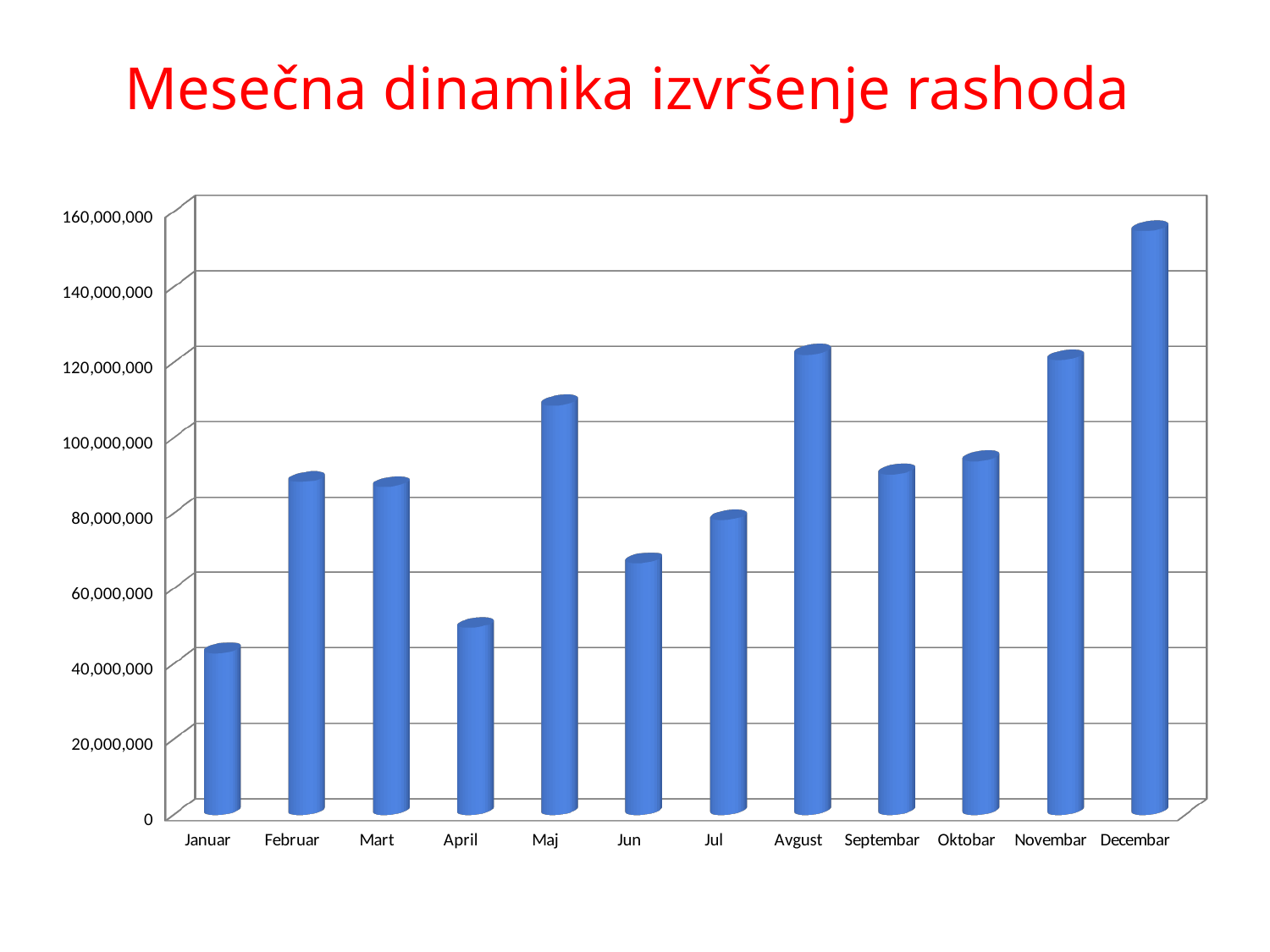
Is the value for Jun greater or less than 80,000,000? less What is the title of the chart? Mesečna dinamika izvršenje rashoda Which is larger, the value for Maj or the value for Jul? Maj From Septembar to Decembar, do the values rise or fall? rise Is the value for Avgust greater or less than 100,000,000? greater Which month has the lowest value? Januar Is the value for Decembar greater or less than 140,000,000? greater How many months (categories) are shown on the x axis? 12 What type of chart is shown on the slide? bar chart Which month has the highest value? Decembar